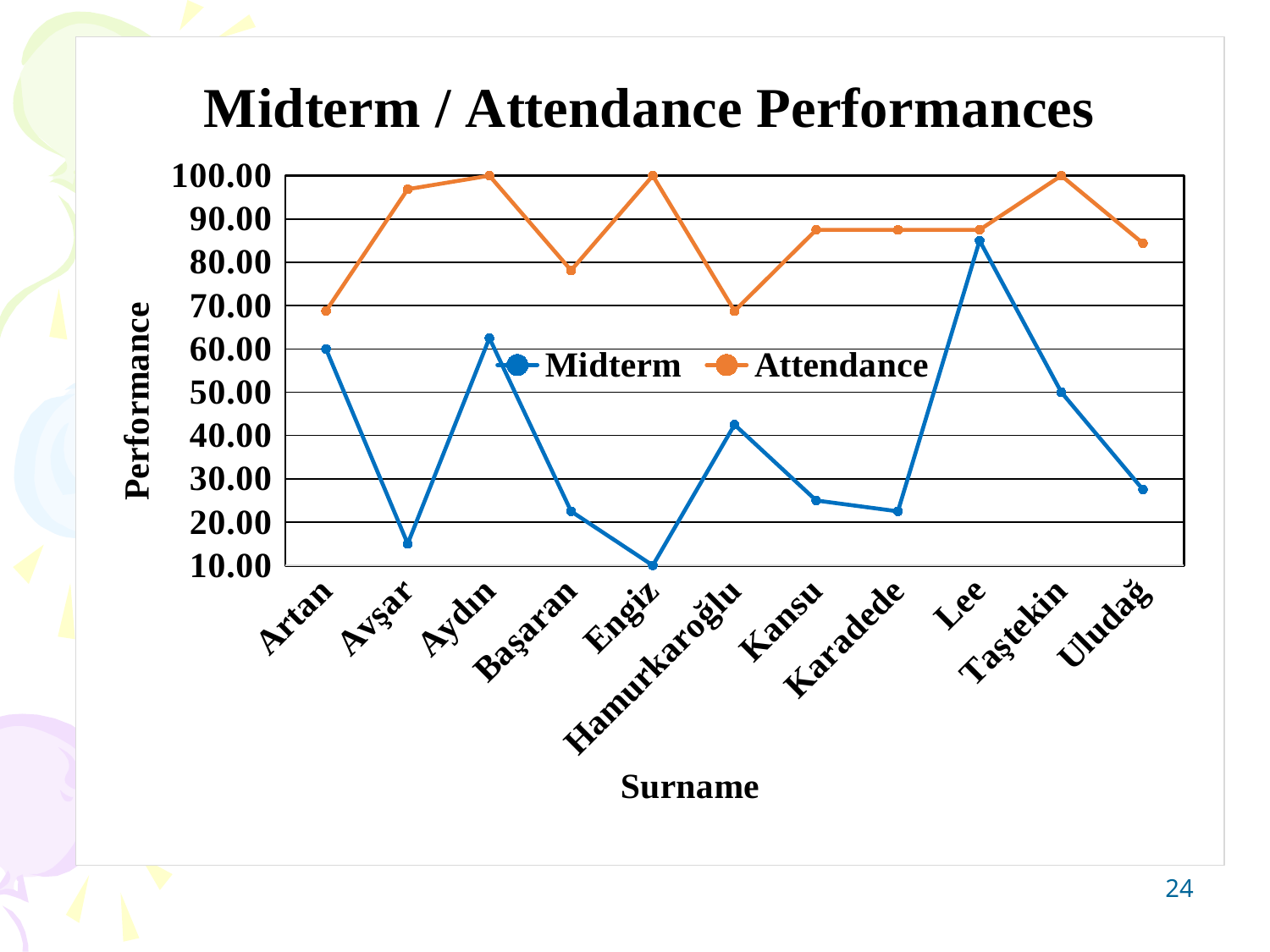
Is the Midterm value for Lee greater or less than 80.00? greater Is the Midterm value for Avşar greater or less than 20.00? less What is the Attendance value for Taştekin? 100.00 Which surname has the lowest Midterm value? Engiz Which surname has the highest Midterm value? Lee How many series does the legend list? 2 How many surnames are plotted along the x axis? 11 Which is larger for Engiz, the Midterm value or the Attendance value? Attendance What is the Attendance value for Aydın? 100.00 Is the Attendance value for Kansu greater or less than 80.00? greater Do the Midterm values rise or fall from Lee to Uludağ? fall What kind of chart is shown on the slide? Line chart